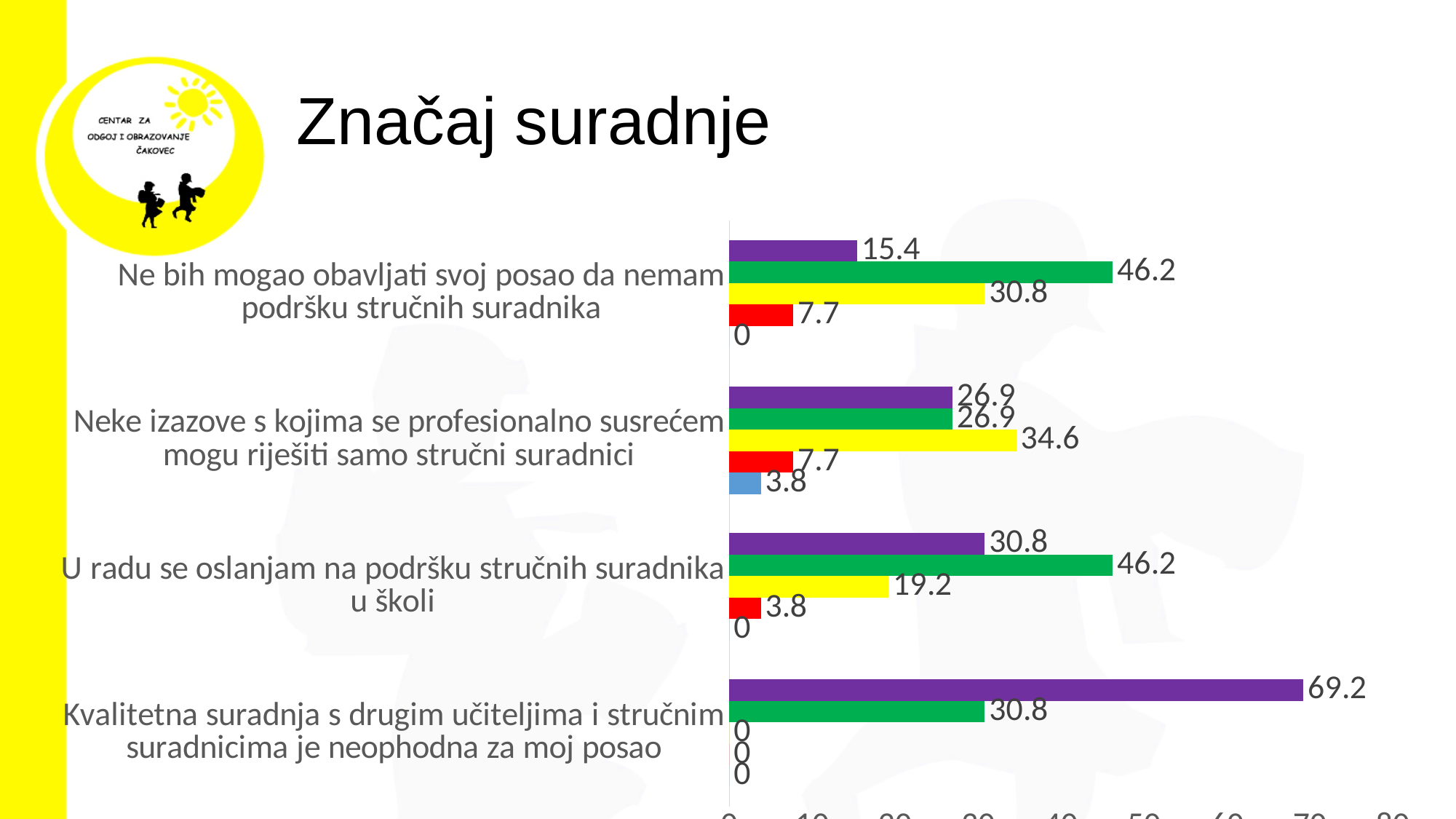
Which category has the lowest purple bar value? Ne bih mogao obavljati svoj posao da nemam podršku stručnih suradnika What is the value of the blue bar for "Neke izazove s kojima se profesionalno susrećem mogu riješiti samo stručni suradnici"? 3.8 What is the value of the purple bar for "Kvalitetna suradnja s drugim učiteljima i stručnim suradnicima je neophodna za moj posao"? 69.2 What is the value of the yellow bar for "Neke izazove s kojima se profesionalno susrećem mogu riješiti samo stručni suradnici"? 34.6 What type of chart is shown on the slide? bar chart For "U radu se oslanjam na podršku stručnih suradnika u školi", which is larger: the green bar or the yellow bar? the green bar What is the value of the green bar for "Ne bih mogao obavljati svoj posao da nemam podršku stručnih suradnika"? 46.2 What is the difference between the purple and green bar values for "Kvalitetna suradnja s drugim učiteljima i stručnim suradnicima je neophodna za moj posao"? 38.4 How many categories (statements) are shown on the chart? 4 What is the value of the red bar for "U radu se oslanjam na podršku stručnih suradnika u školi"? 3.8 What is the title of the slide containing the chart? Značaj suradnje Which category has the highest purple bar value? Kvalitetna suradnja s drugim učiteljima i stručnim suradnicima je neophodna za moj posao